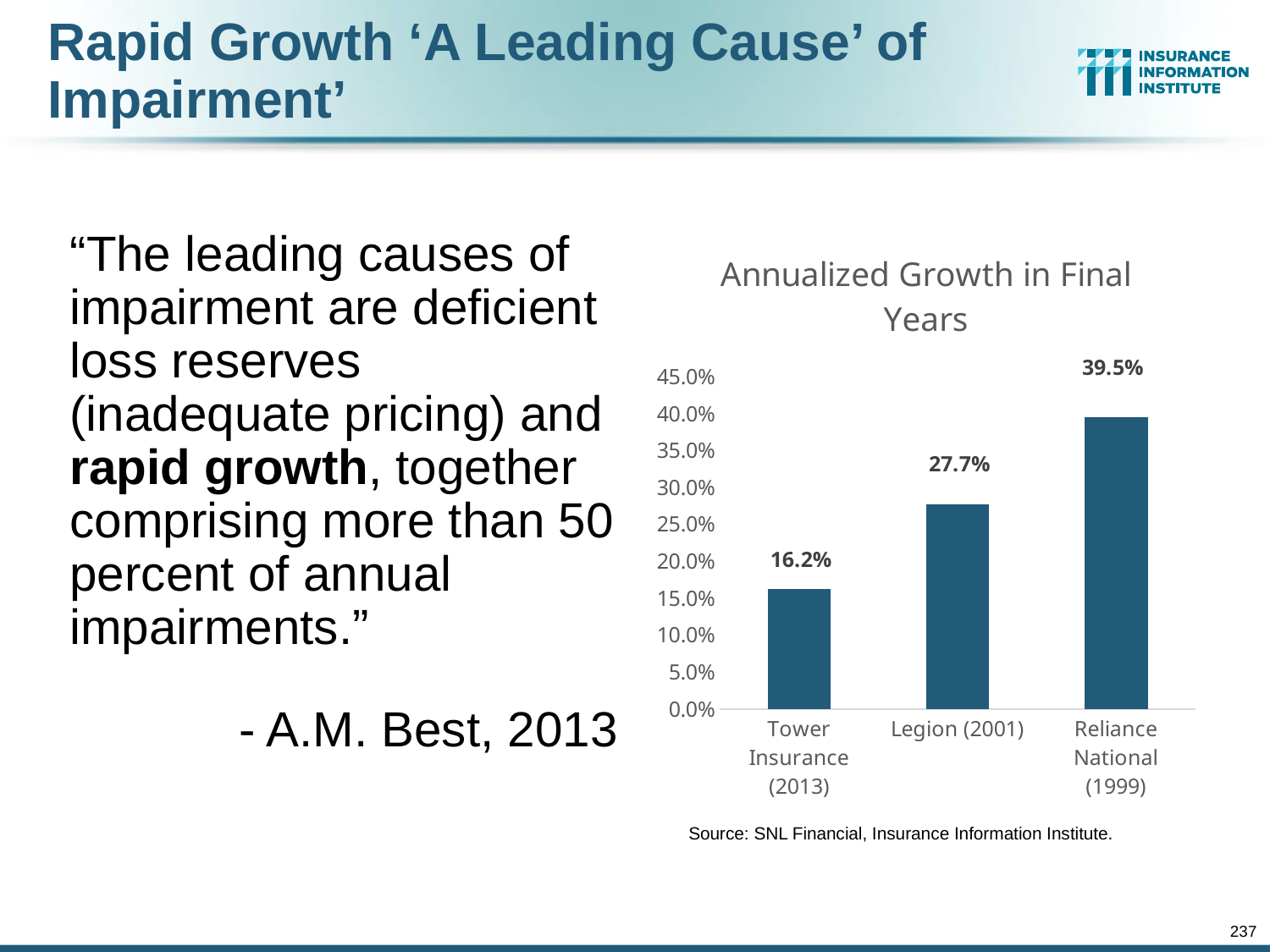
Is the annualized growth for Reliance National (1999) greater or less than 35.0%? greater What is the title of the chart? Annualized Growth in Final Years What kind of chart is shown on the slide? Bar chart Which company has the lowest annualized growth in final years? Tower Insurance (2013) Which company has the highest annualized growth in final years? Reliance National (1999) What is the difference in annualized growth between Reliance National (1999) and Tower Insurance (2013)? 23.3% Which has a higher annualized growth in final years, Legion (2001) or Tower Insurance (2013)? Legion (2001) How many companies are shown in the chart? 3 What is the annualized growth in final years for Reliance National (1999)? 39.5% What is the annualized growth in final years for Legion (2001)? 27.7% What is the annualized growth in final years for Tower Insurance (2013)? 16.2% What is the difference in annualized growth between Legion (2001) and Tower Insurance (2013)? 11.5%